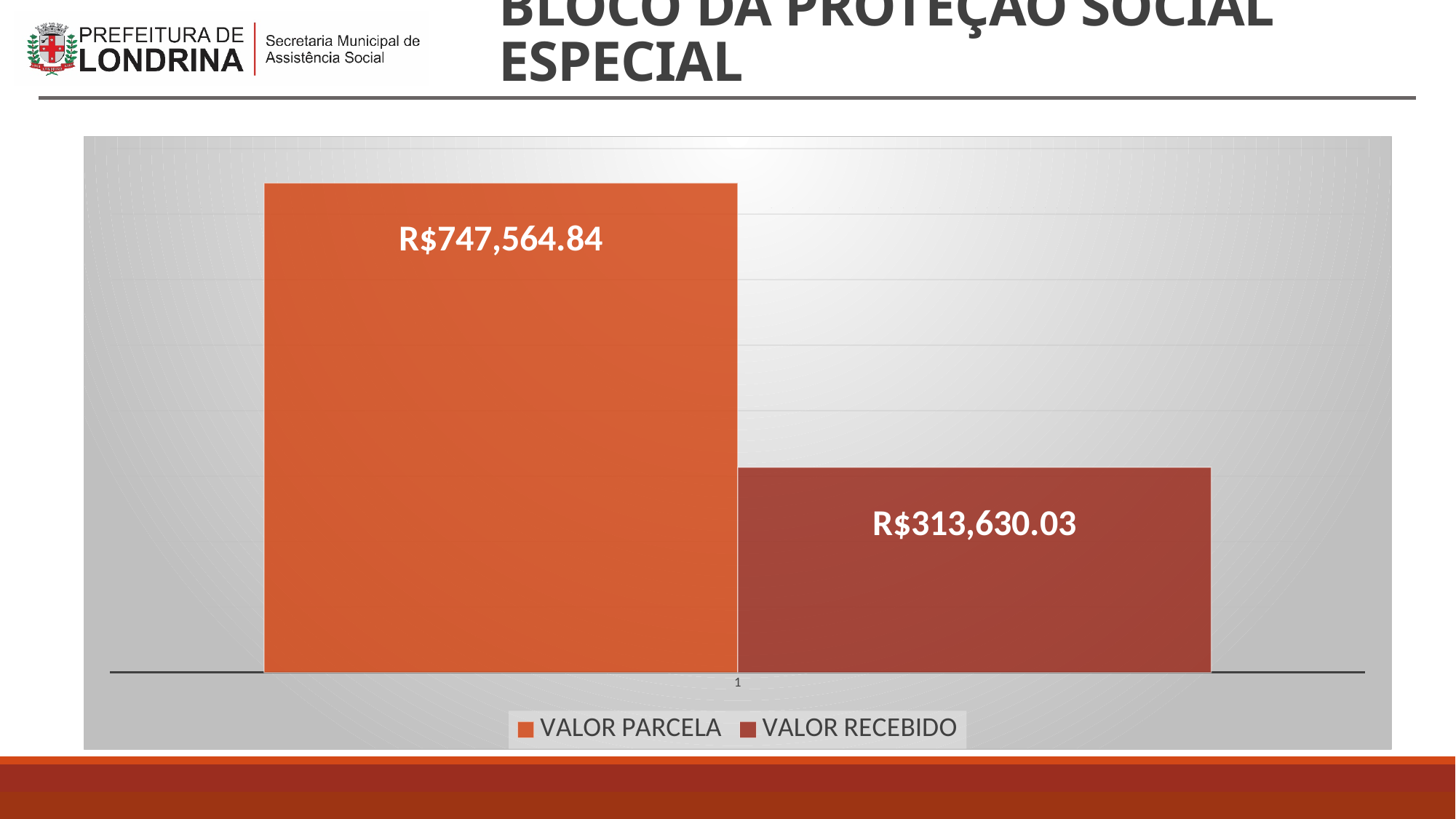
What kind of chart is shown on the slide? Bar chart Which series has the higher value, VALOR PARCELA or VALOR RECEBIDO? VALOR PARCELA How many bars are plotted on the chart? 2 What is the difference between VALOR PARCELA and VALOR RECEBIDO? R$433,934.81 Which series has the highest value on the chart? VALOR PARCELA What is the title of the slide containing the chart? BLOCO DA PROTEÇÃO SOCIAL ESPECIAL Which legend entry is shown in the darker red colour? VALOR RECEBIDO What is the value for VALOR PARCELA? R$747,564.84 What is the value for VALOR RECEBIDO? R$313,630.03 How many series does the legend list? 2 Which series has the lowest value on the chart? VALOR RECEBIDO